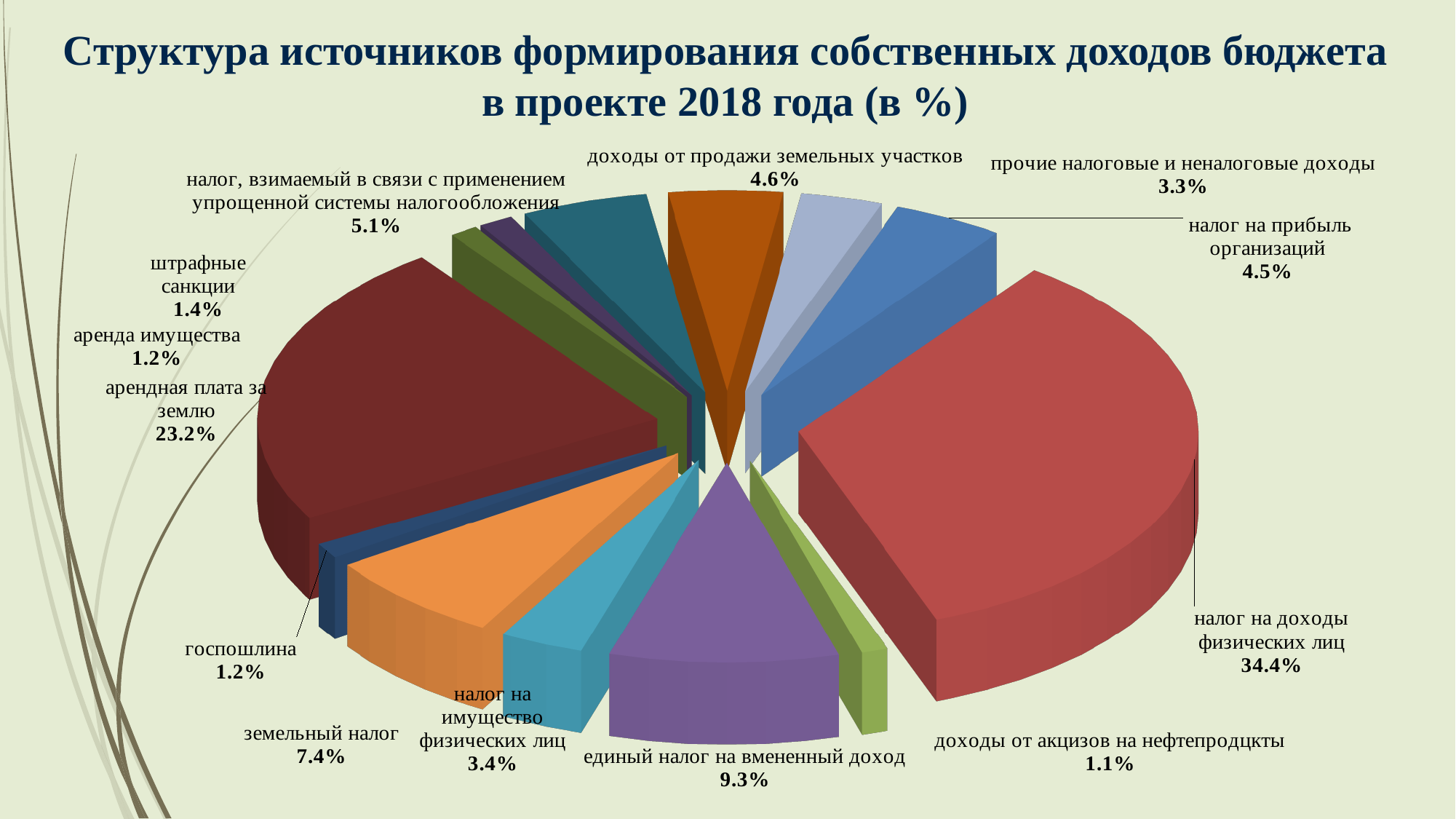
Which revenue source has the largest share in the pie chart? налог на доходы физических лиц What is the value shown for арендная плата за землю? 23.2% What type of chart is shown on the slide? pie chart What is the value for земельный налог? 7.4% Which revenue source has the smallest share in the pie chart? доходы от акцизов на нефтепродукты How many revenue sources (slices) are shown in the pie chart? 13 What percentage is shown for доходы от продажи земельных участков? 4.6% What percentage is shown for единый налог на вмененный доход? 9.3% For which year's draft budget does the chart show the structure of own revenue sources? 2018 What is the difference in percentage points between налог на доходы физических лиц and арендная плата за землю? 11.2 What share of the budget's own revenues comes from налог на доходы физических лиц? 34.4% Which is larger: the share for земельный налог or the share for налог на имущество физических лиц? земельный налог